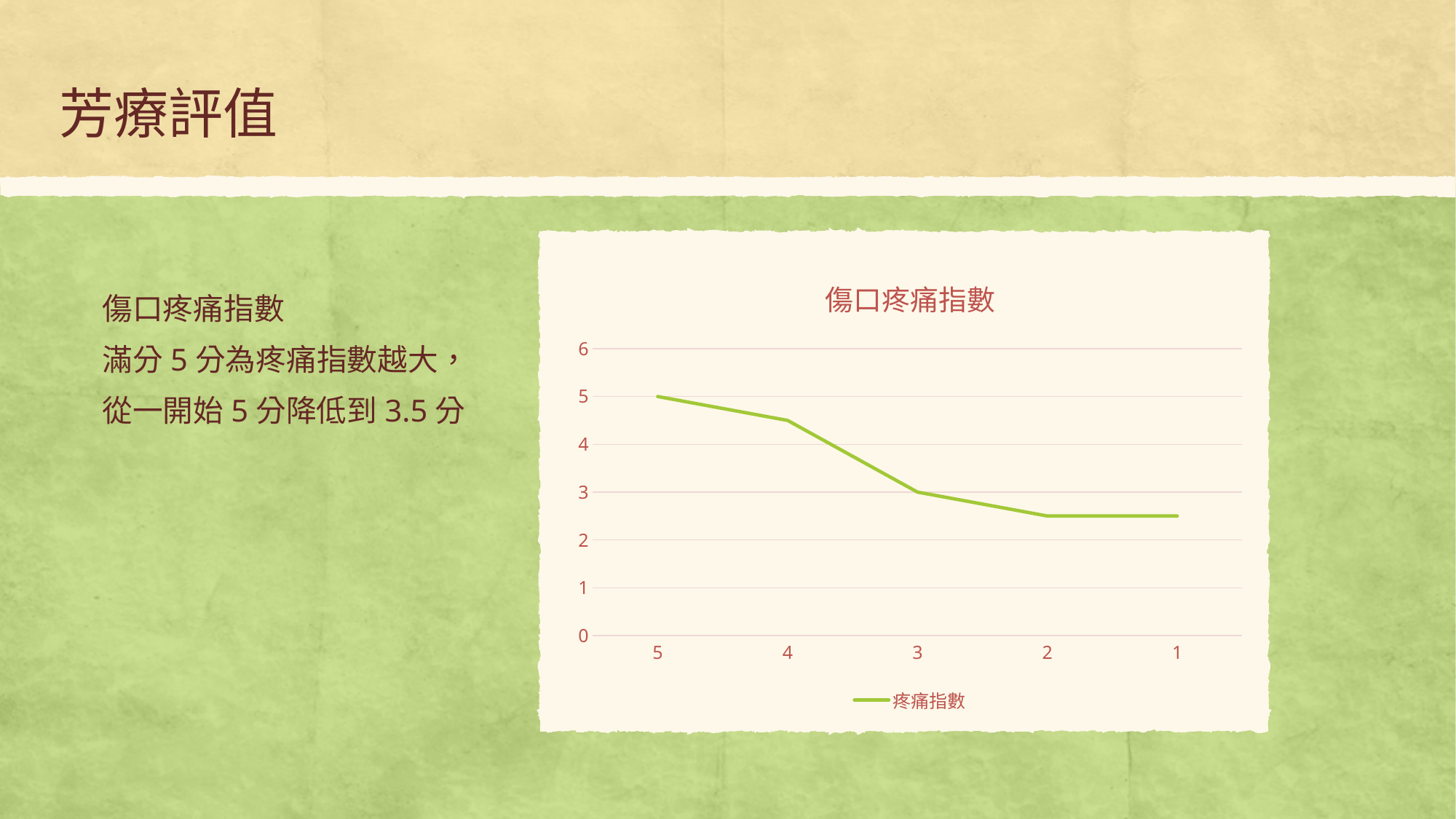
How many series does the legend list? 1 What is the title of the chart? 傷口疼痛指數 Is the value for x-axis category 4 greater or less than 4? greater What is the value of 疼痛指數 at x-axis category 5? 5 Which x-axis category has the highest 疼痛指數 value? 5 How many data points are plotted on the line? 5 Is the value for x-axis category 2 greater or less than 3? less What is the value of 疼痛指數 at x-axis category 3? 3 What kind of chart is shown on the slide? line chart What series name does the legend show? 疼痛指數 Do the values rise or fall moving from left to right along the x axis? fall Which is larger, the value at x-axis category 4 or at category 3? 4